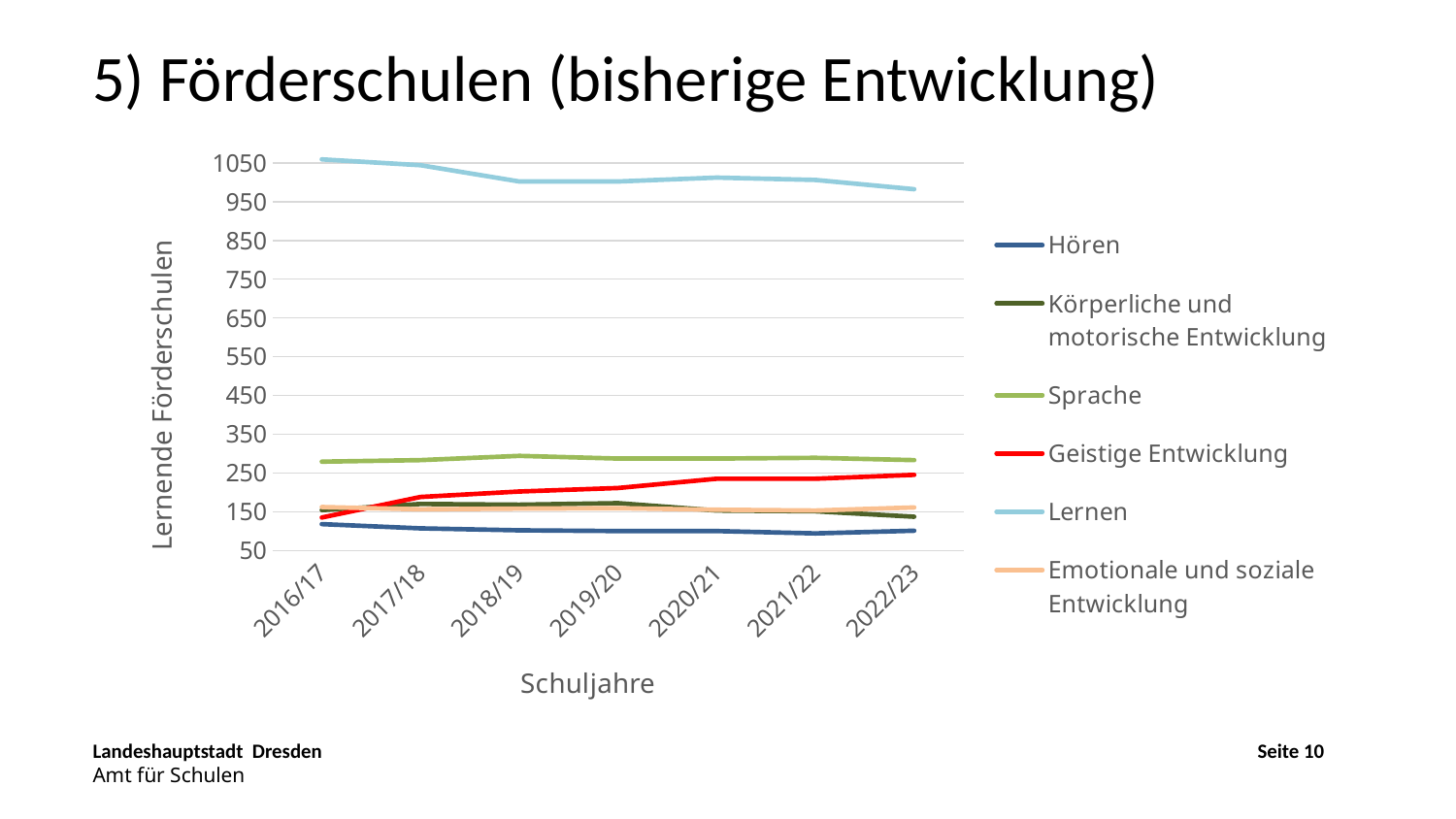
How many school years are plotted along the x axis? 7 What is the title of the x axis? Schuljahre Does the Lernen series rise or fall from 2016/17 to 2022/23? fall Is the value for Sprache in 2018/19 greater or less than 250? greater Is the value for Hören in 2021/22 greater or less than 150? less Which series has the highest values across all school years? Lernen Is the value for Lernen in 2022/23 greater or less than 950? greater Does the Geistige Entwicklung series rise or fall from 2016/17 to 2022/23? rise What kind of chart is shown on the slide? line chart In 2016/17, which is larger: Sprache or Geistige Entwicklung? Sprache How many series does the legend list? 6 Which series has the lowest value in 2021/22? Hören